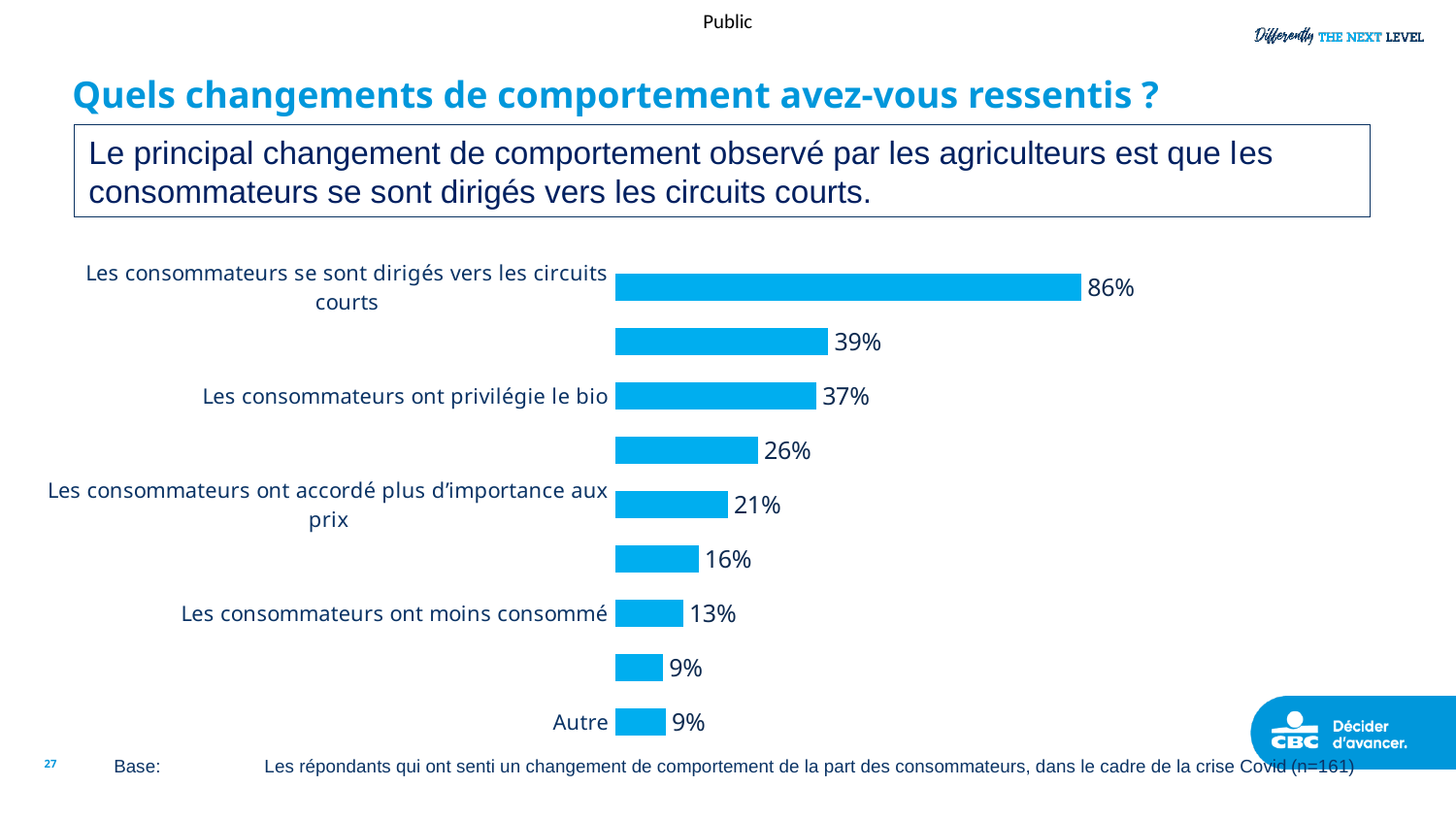
Which category has the highest percentage in the chart? Les consommateurs se sont dirigés vers les circuits courts Which is larger: the value for "Les consommateurs ont privilégie le bio" or for "Les consommateurs ont moins consommé"? Les consommateurs ont privilégie le bio What percentage is shown for "Les consommateurs se sont dirigés vers les circuits courts"? 86% How many bars are plotted in the chart? 9 What is the difference in percentage points between "Les consommateurs ont accordé plus d'importance aux prix" and "Les consommateurs ont moins consommé"? 8 percentage points What is the difference in percentage points between "Les consommateurs se sont dirigés vers les circuits courts" and "Les consommateurs ont privilégie le bio"? 49 percentage points What percentage is shown for "Les consommateurs ont moins consommé"? 13% What percentage is shown for "Autre"? 9% What percentage is shown for "Les consommateurs ont accordé plus d'importance aux prix"? 21% What percentage is shown for "Les consommateurs ont privilégie le bio"? 37% What type of chart is shown on the slide? Bar chart What is the lowest percentage value shown in the chart? 9%